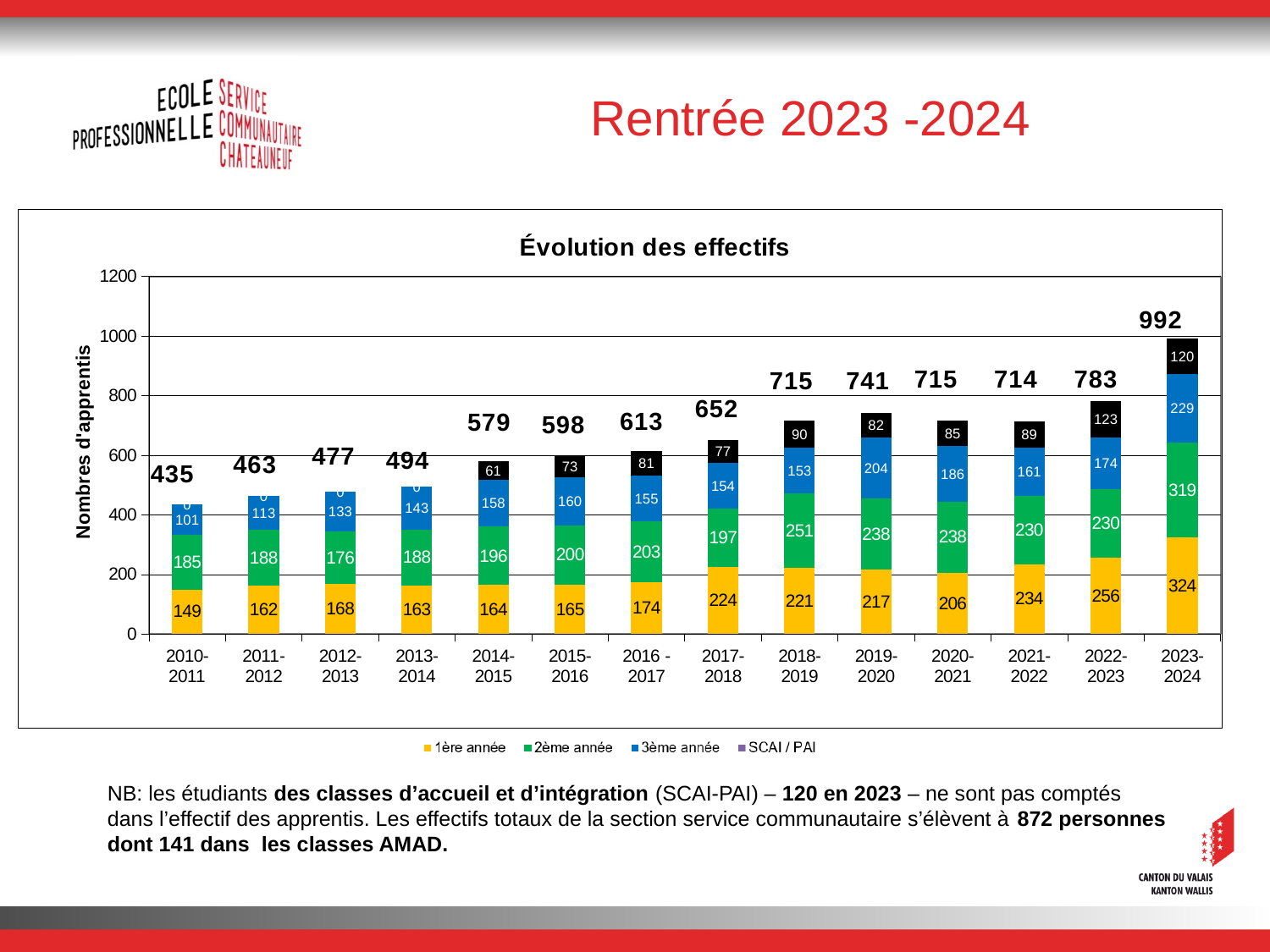
How many school years are shown on the x axis? 14 What kind of chart is shown? Stacked bar chart What is the value for 3ème année in 2019-2020? 204 What is the title of the chart? Évolution des effectifs What is the total number of apprentices shown for 2023-2024? 992 What is the difference between the totals for 2023-2024 and 2022-2023? 209 What is the value for 1ère année in 2023-2024? 324 Which is larger, the 2ème année value in 2018-2019 or in 2019-2020? 2018-2019 Which year has the highest total number of apprentices? 2023-2024 What is the value for SCAI / PAI in 2022-2023? 123 How many series does the legend list? 4 Which year has the lowest total number of apprentices? 2010-2011